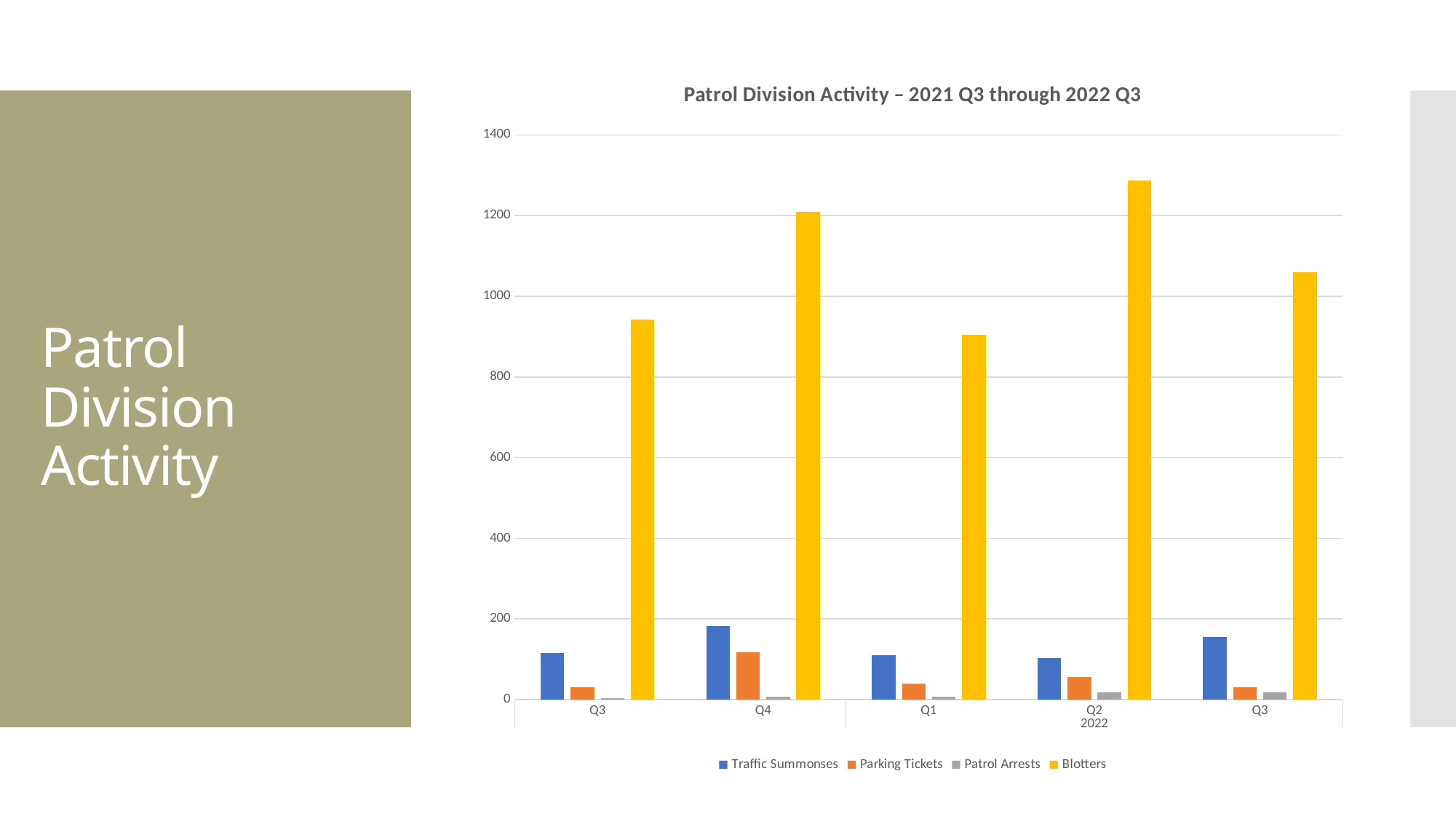
How many quarters are shown on the x axis? 5 Is the Blotters value for 2022 Q2 greater or less than 1200? greater What kind of chart is shown on the slide? bar chart In which quarter is the Parking Tickets value highest? 2021 Q4 Which is larger, the Blotters value for 2021 Q4 or for 2022 Q2? 2022 Q2 How many series does the legend list? 4 In which quarter is the Traffic Summonses value highest? 2021 Q4 Is the Blotters value for 2021 Q3 greater or less than 1000? less Is the Traffic Summonses value for 2021 Q4 greater or less than 200? less In which quarter is the Blotters value highest? 2022 Q2 What is the title of the chart? Patrol Division Activity – 2021 Q3 through 2022 Q3